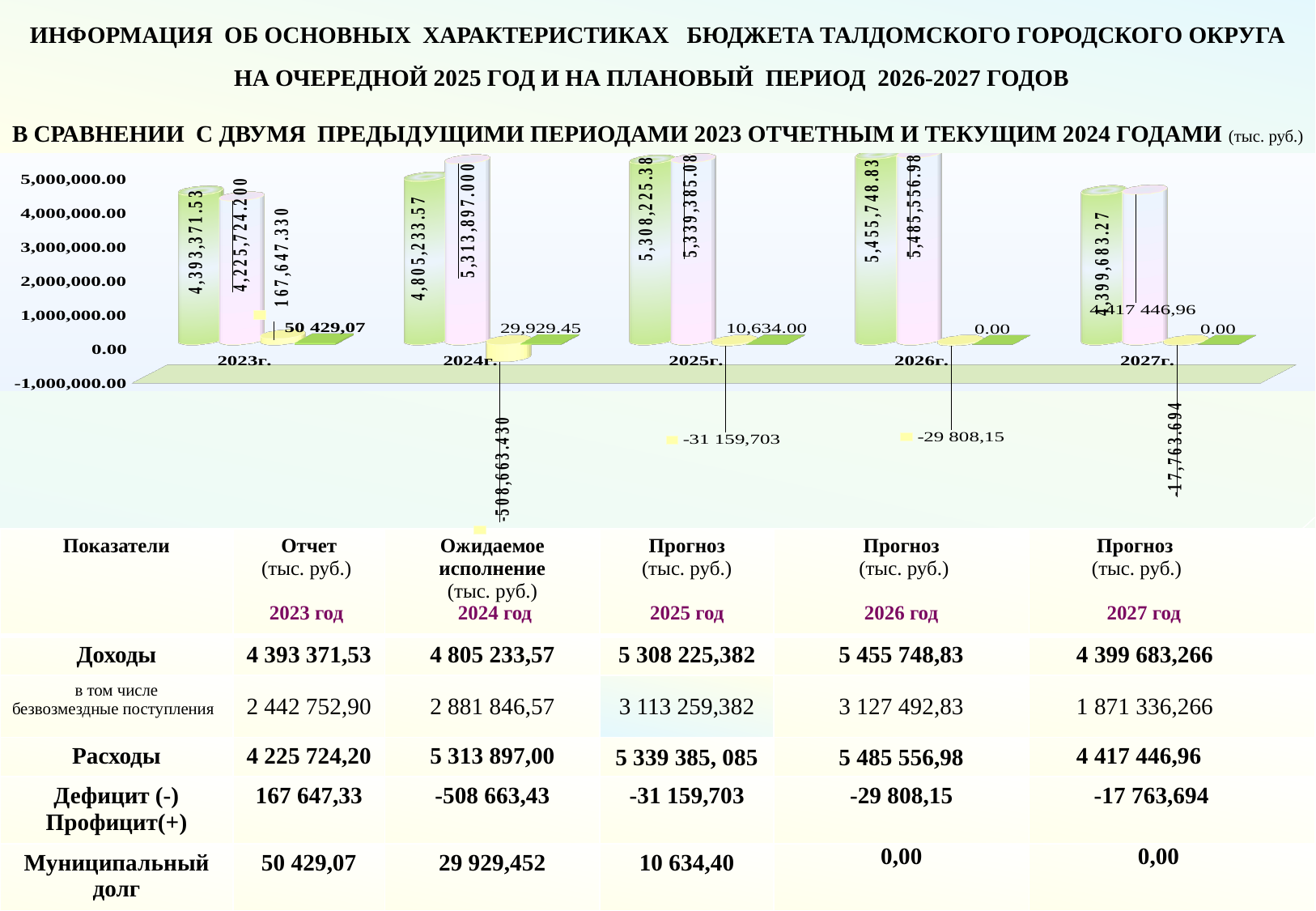
What is the deficit value labelled below the axis for 2024г. in the chart? -508,663.430 Which year has the highest green (income) bar in the chart? 2026г. Which year has the lowest green (income) bar in the chart? 2023г. What is the data label on the first (green) bar for 2026г. in the chart? 5,455,748.83 In the chart, which is larger for 2024г.: the green bar (4,805,233.57) or the pink bar (5,313,897.000)? the pink bar (5,313,897.000) What kind of chart is shown on the slide? bar chart What is the data label on the first (green) bar for 2024г. in the chart? 4,805,233.57 What value is labelled for the municipal debt (last bar) for 2025г. in the chart? 10,634.00 In the chart, is the green bar for 2023г. greater or less than 4,000,000.00? greater What value is labelled for the municipal debt (last bar) for 2023г. in the chart? 50 429,07 How many year categories are shown on the x axis of the chart? 5 What is the data label on the second (pink) bar for 2025г. in the chart? 5,339,385.08